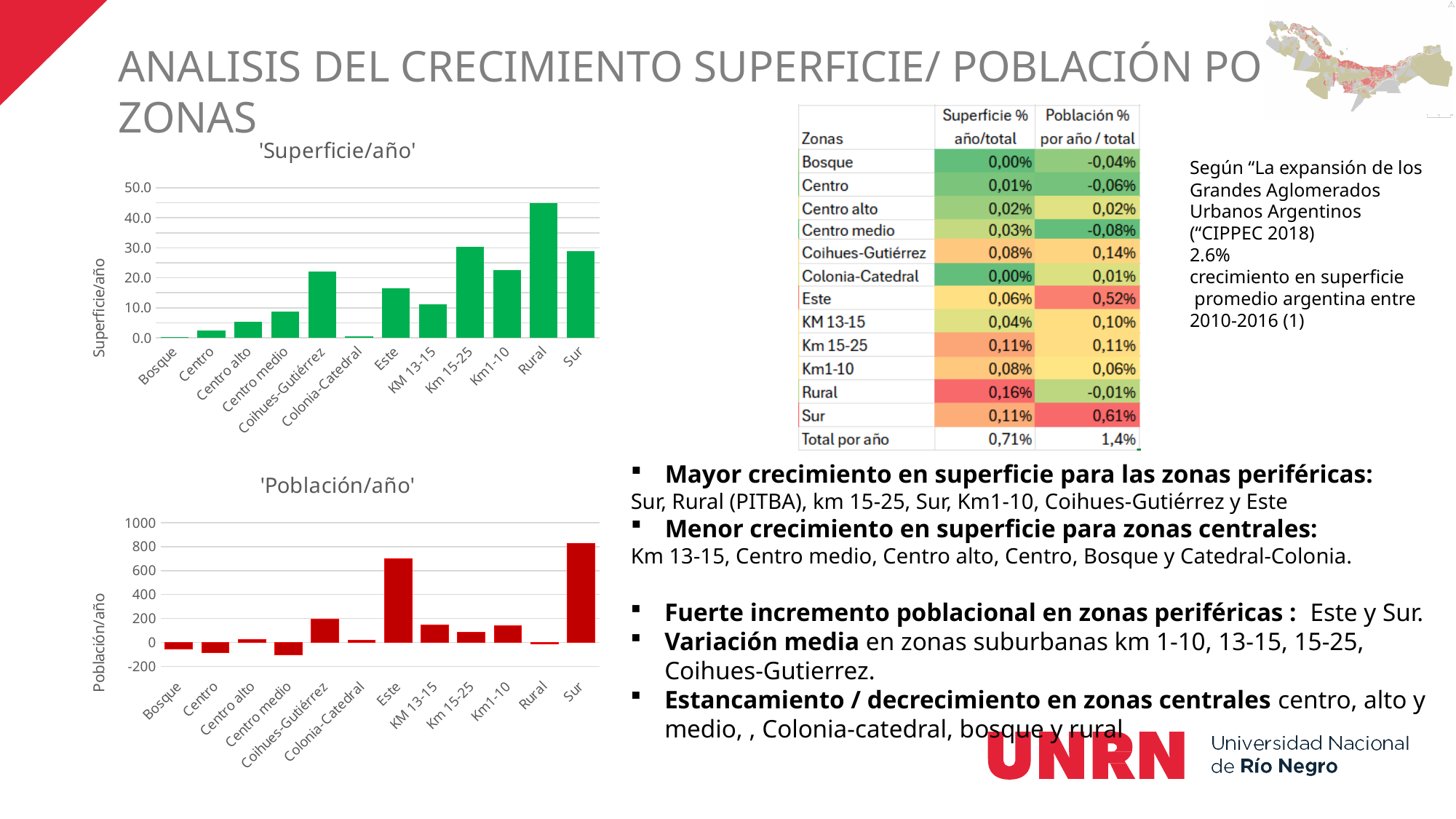
In the 'Población/año' chart, which zone has the highest value? Sur In the 'Superficie/año' chart, is the value for Rural greater or less than 40? greater In the 'Superficie/año' chart, is the value for Coihues-Gutiérrez greater or less than 20? greater In the 'Población/año' chart, is the value for Este greater or less than 600? greater In the 'Superficie/año' chart, which is larger, the value for Este or the value for Km 15-25? Km 15-25 What kind of chart is the 'Superficie/año' chart? bar chart In the 'Población/año' chart, which is larger, the value for Km1-10 or the value for Este? Este How many zones are shown on the x axis of the 'Superficie/año' chart? 12 In the 'Superficie/año' chart, which zone has the highest value? Rural What kind of chart is the 'Población/año' chart? bar chart